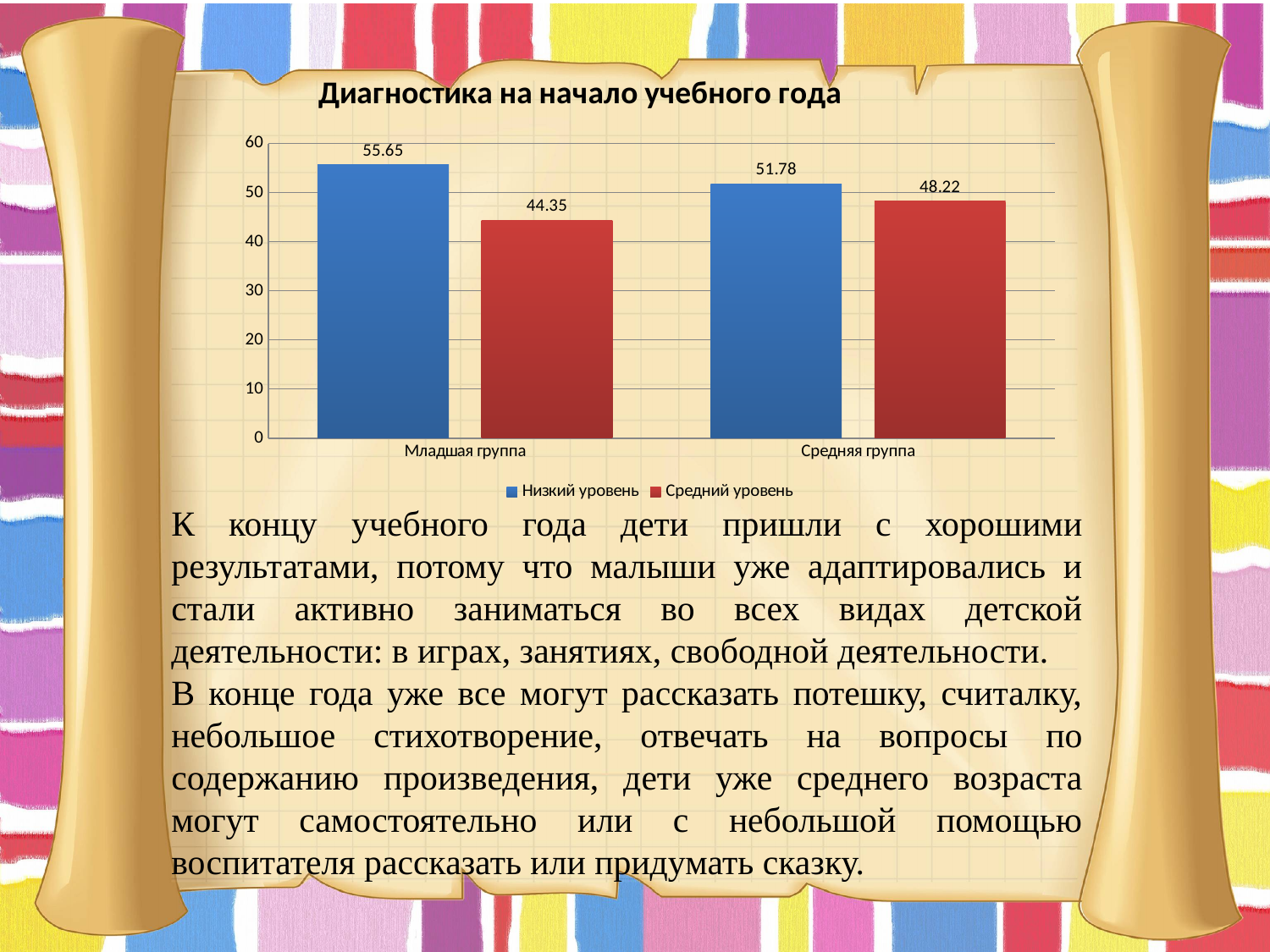
Which bar has the highest value on the chart? Низкий уровень, Младшая группа What is the title of the chart? Диагностика на начало учебного года Which bar has the lowest value on the chart? Средний уровень, Младшая группа Is the value for Средний уровень in Средняя группа greater or less than 50? less How many series does the legend list? 2 How many groups (categories) are shown on the x axis? 2 What is the value for Низкий уровень in Средняя группа? 51.78 What is the difference between Низкий уровень and Средний уровень in Младшая группа? 11.3 What is the value for Средний уровень in Средняя группа? 48.22 What is the value for Средний уровень in Младшая группа? 44.35 Which is larger in Средняя группа: Низкий уровень or Средний уровень? Низкий уровень What is the value for Низкий уровень in Младшая группа? 55.65